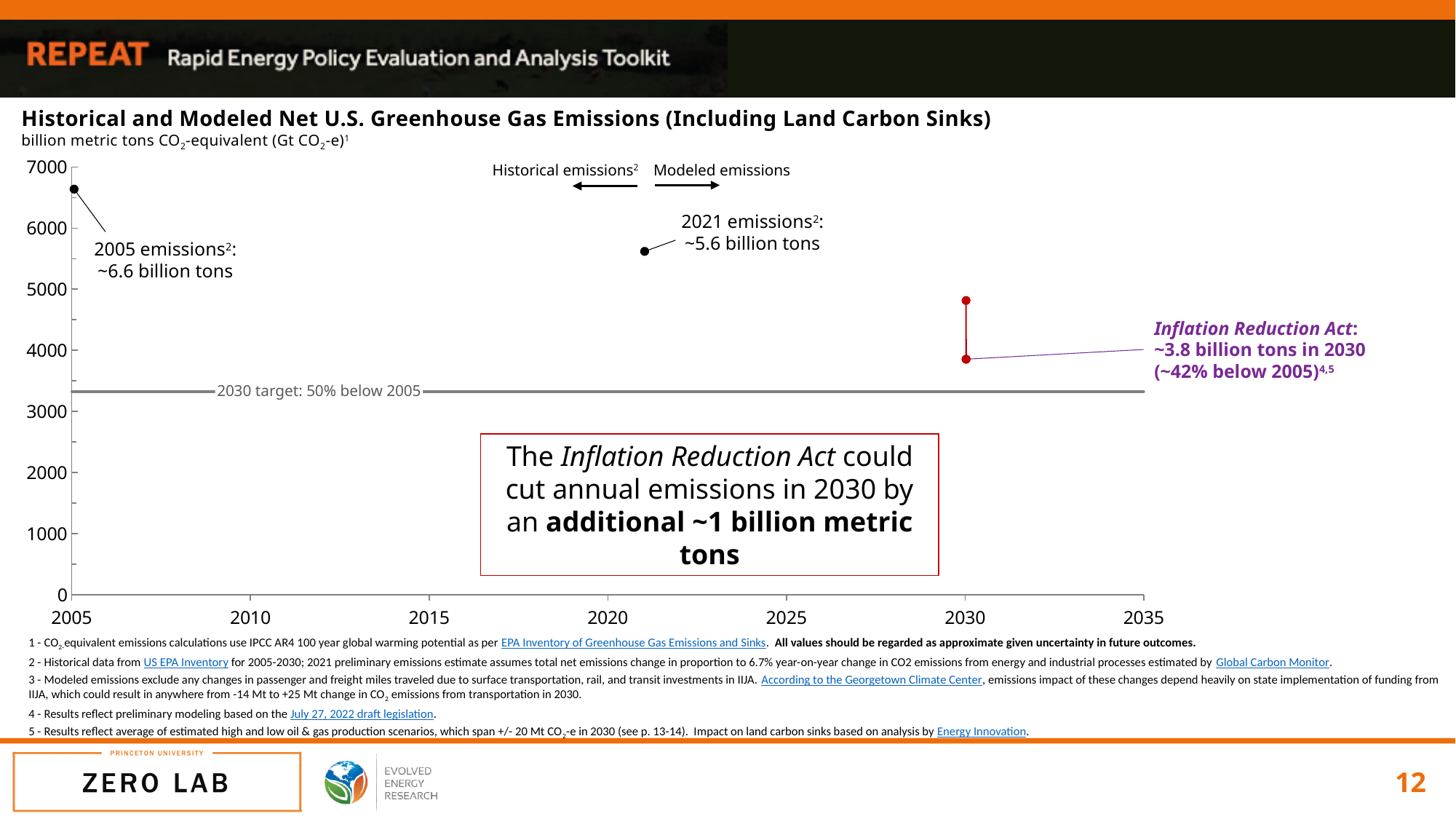
Which is larger, the 2005 emissions or the 2021 emissions? 2005 emissions Is the 2005 emissions point greater or less than 6000 on the y axis? greater What is the title of the chart? Historical and Modeled Net U.S. Greenhouse Gas Emissions (Including Land Carbon Sinks) Which plotted point has the highest emissions value? 2005 emissions What are the 2005 emissions according to the chart's data label? ~6.6 billion tons Is the 2021 emissions point greater or less than 5000 on the y axis? greater Is the Inflation Reduction Act 2030 emissions point greater or less than 4000 on the y axis? less What are the modeled 2030 emissions under the Inflation Reduction Act according to the chart's label? ~3.8 billion tons By how much could the Inflation Reduction Act cut annual emissions in 2030, according to the chart's callout? an additional ~1 billion metric tons Do the plotted emissions values rise or fall from 2005 to 2030? fall What are the 2021 emissions according to the chart's data label? ~5.6 billion tons